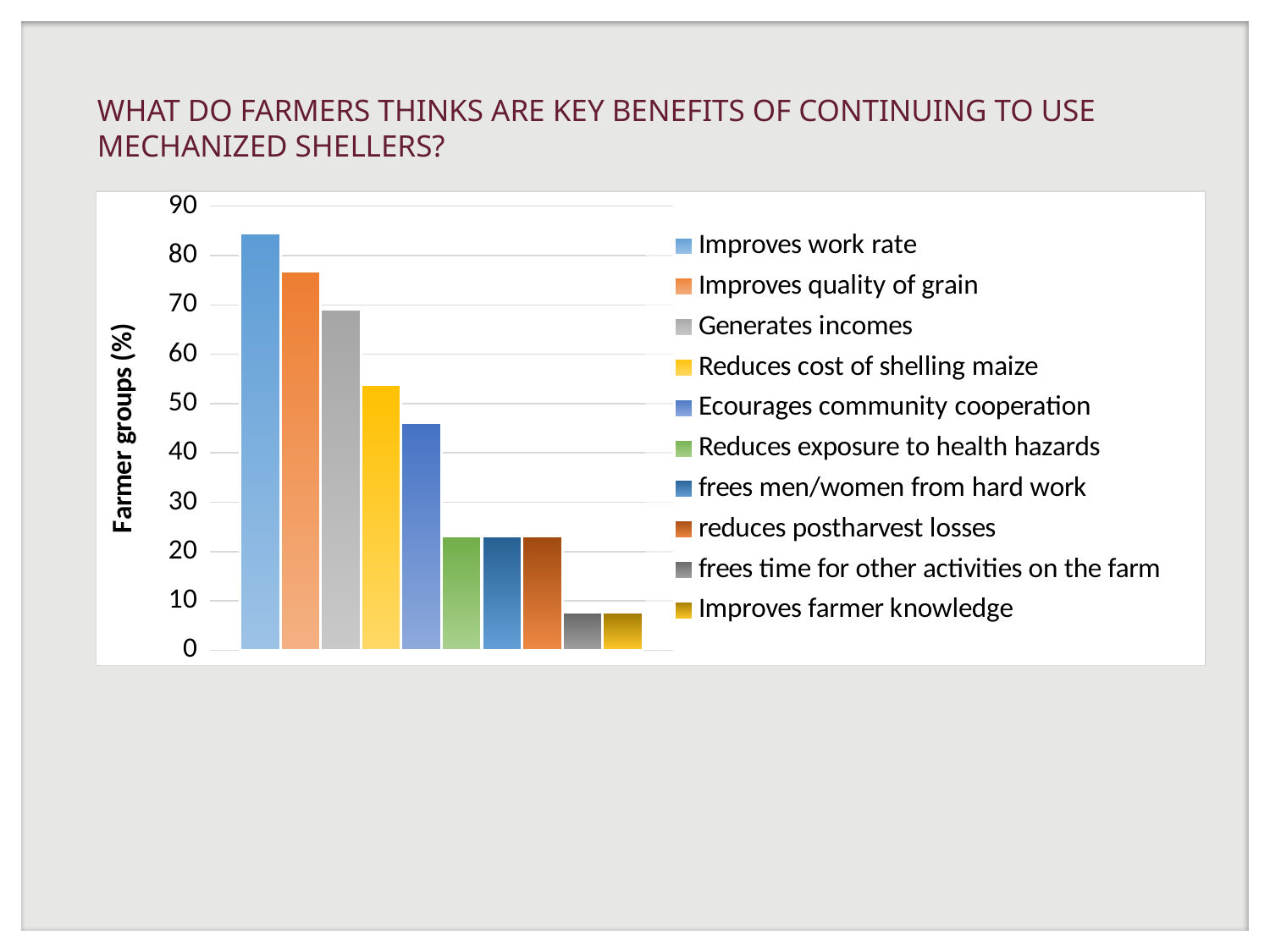
Is the value for Improves farmer knowledge greater or less than 10? less What kind of chart is shown on the slide? bar chart Which benefit has the highest value in the chart? Improves work rate Is the value for Generates incomes greater or less than 60? greater Is the value for Improves work rate greater or less than 80? greater How many bars are plotted in the chart? 10 Do the bar values rise or fall moving from left to right across the chart? fall Which is larger, the value for Improves quality of grain or the value for Reduces cost of shelling maize? Improves quality of grain How many series does the legend list? 10 What is the label on the vertical axis of the chart? Farmer groups (%)